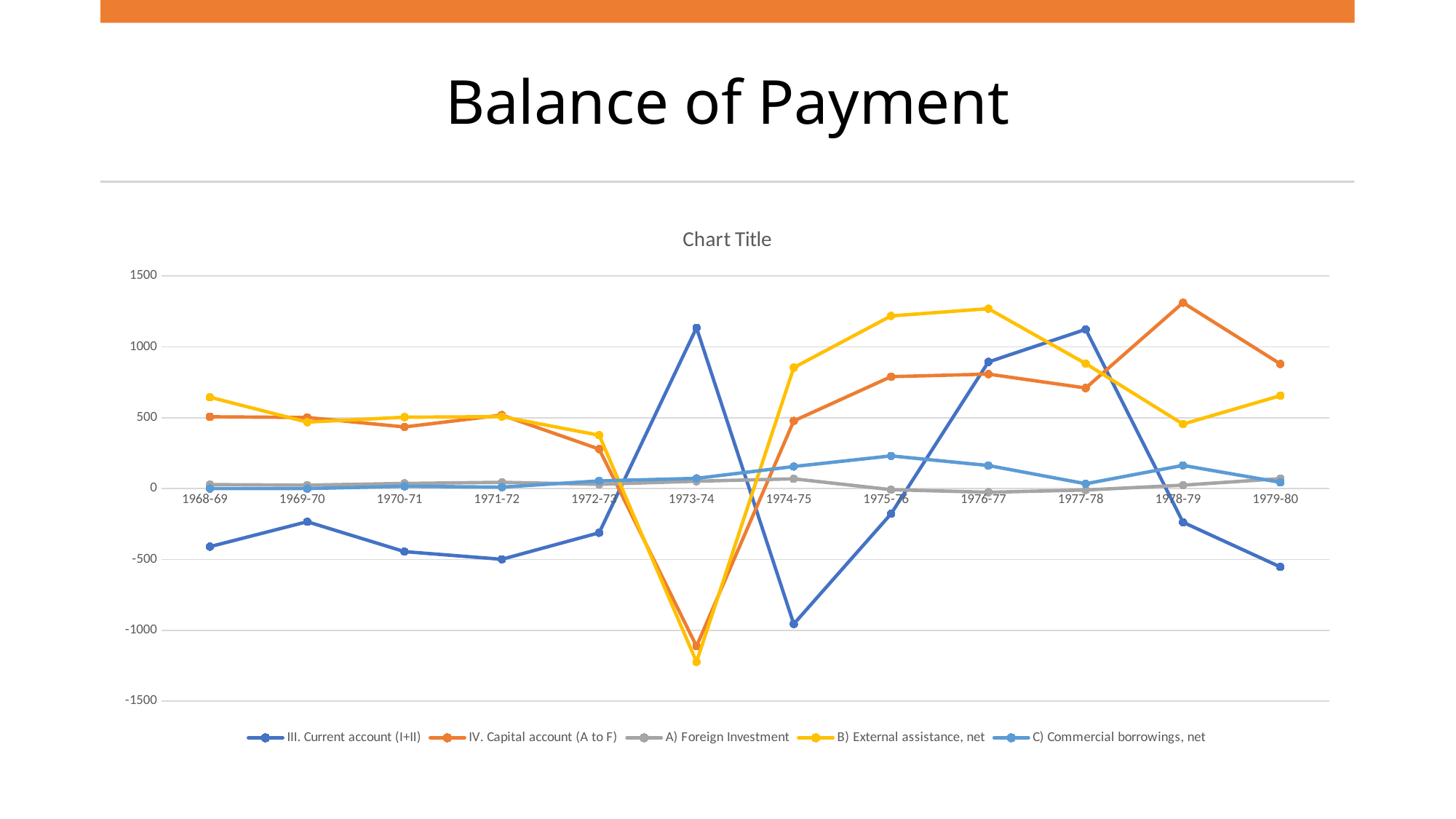
Is the value for IV. Capital account (A to F) in 1978-79 greater or less than 1000? greater Does the value for B) External assistance, net rise or fall from 1974-75 to 1976-77? rise Is the value for B) External assistance, net in 1973-74 greater or less than -1000? less In which year is the value for C) Commercial borrowings, net highest? 1975-76 In 1973-74, which is larger: III. Current account (I+II) or IV. Capital account (A to F)? III. Current account (I+II) Is the value for III. Current account (I+II) in 1974-75 greater or less than -500? less How many series does the legend list? 5 In which year is the value for B) External assistance, net lowest? 1973-74 In which year is the value for IV. Capital account (A to F) highest? 1978-79 In which year is the value for III. Current account (I+II) lowest? 1974-75 How many years are shown along the x axis? 12 What kind of chart is shown on the slide? line chart